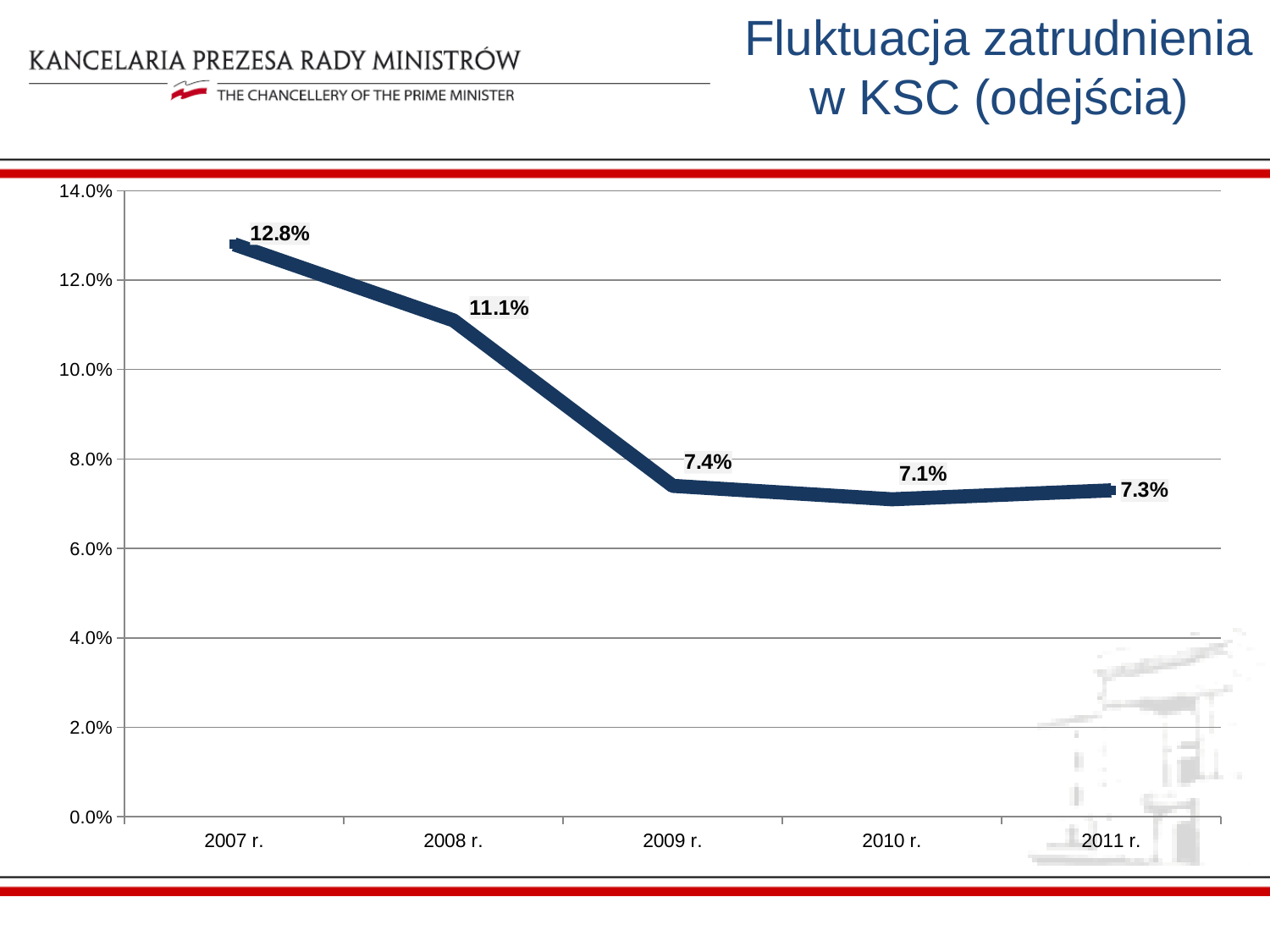
Do the values rise or fall from 2007 r. to 2009 r.? fall What is the value for 2009 r.? 7.4% Is the value for 2008 r. greater or less than 10.0%? greater Which year has the highest value? 2007 r. What is the difference between the values for 2008 r. and 2009 r.? 3.7% What is the difference between the values for 2007 r. and 2008 r.? 1.7% Which is larger, the value for 2009 r. or the value for 2011 r.? 2009 r. Which year has the lowest value? 2010 r. How many years are plotted on the x axis? 5 What is the value for 2007 r.? 12.8% What is the value for 2011 r.? 7.3% What kind of chart is shown on the slide? line chart